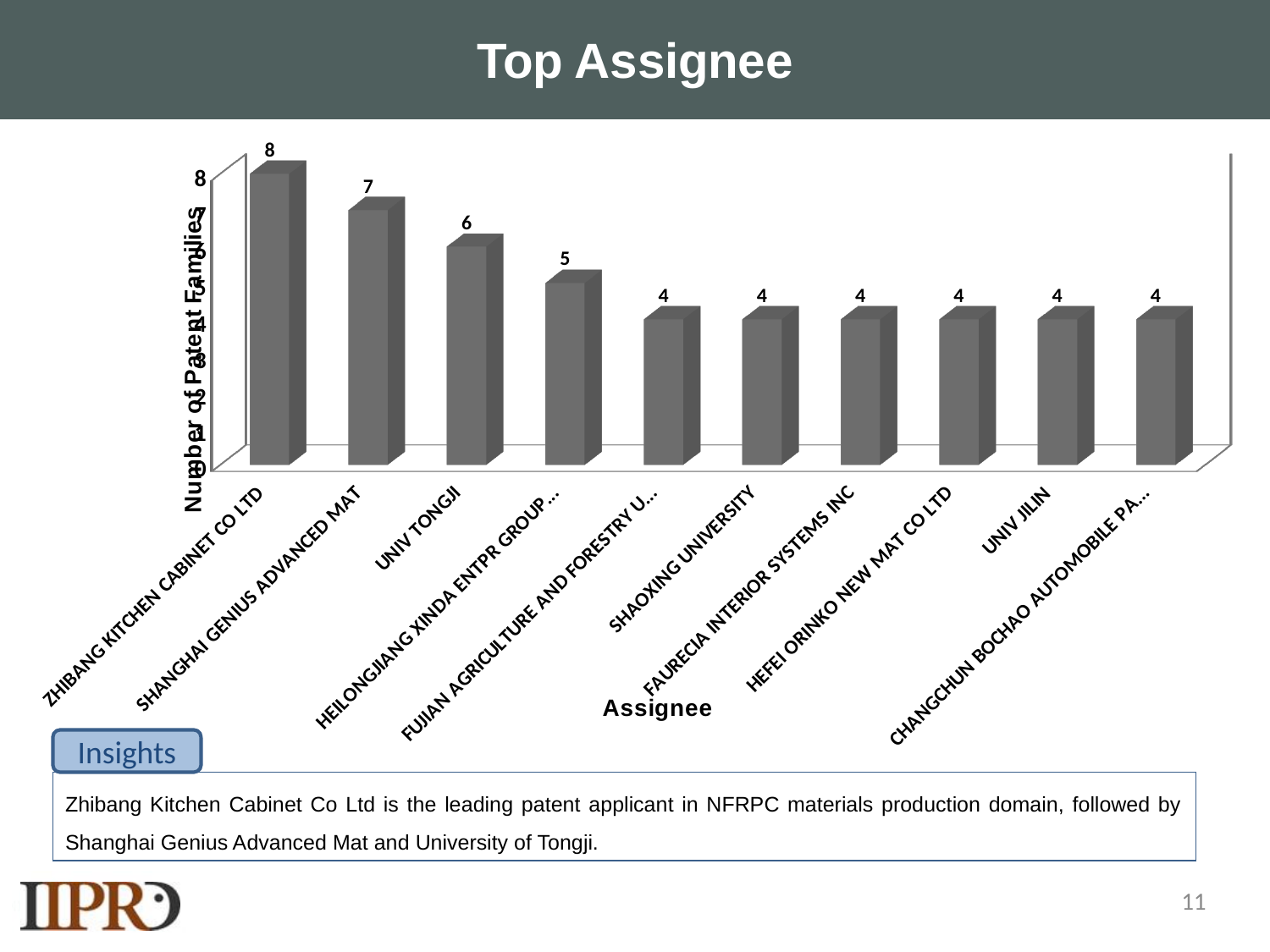
What is the difference in patent families between ZHIBANG KITCHEN CABINET CO LTD and UNIV TONGJI? 2 What is the number of patent families for SHAOXING UNIVERSITY? 4 How many assignees are shown in the chart? 10 Which has more patent families, SHANGHAI GENIUS ADVANCED MAT or UNIV JILIN? SHANGHAI GENIUS ADVANCED MAT Which assignee has the highest number of patent families? ZHIBANG KITCHEN CABINET CO LTD What is the number of patent families for SHANGHAI GENIUS ADVANCED MAT? 7 What is the number of patent families for ZHIBANG KITCHEN CABINET CO LTD? 8 Do the values rise or fall from left to right along the x axis? Fall What is the number of patent families for UNIV TONGJI? 6 What kind of chart is shown on the slide? Bar chart How many assignees have exactly 4 patent families? 6 What is the label of the x axis of the chart? Assignee